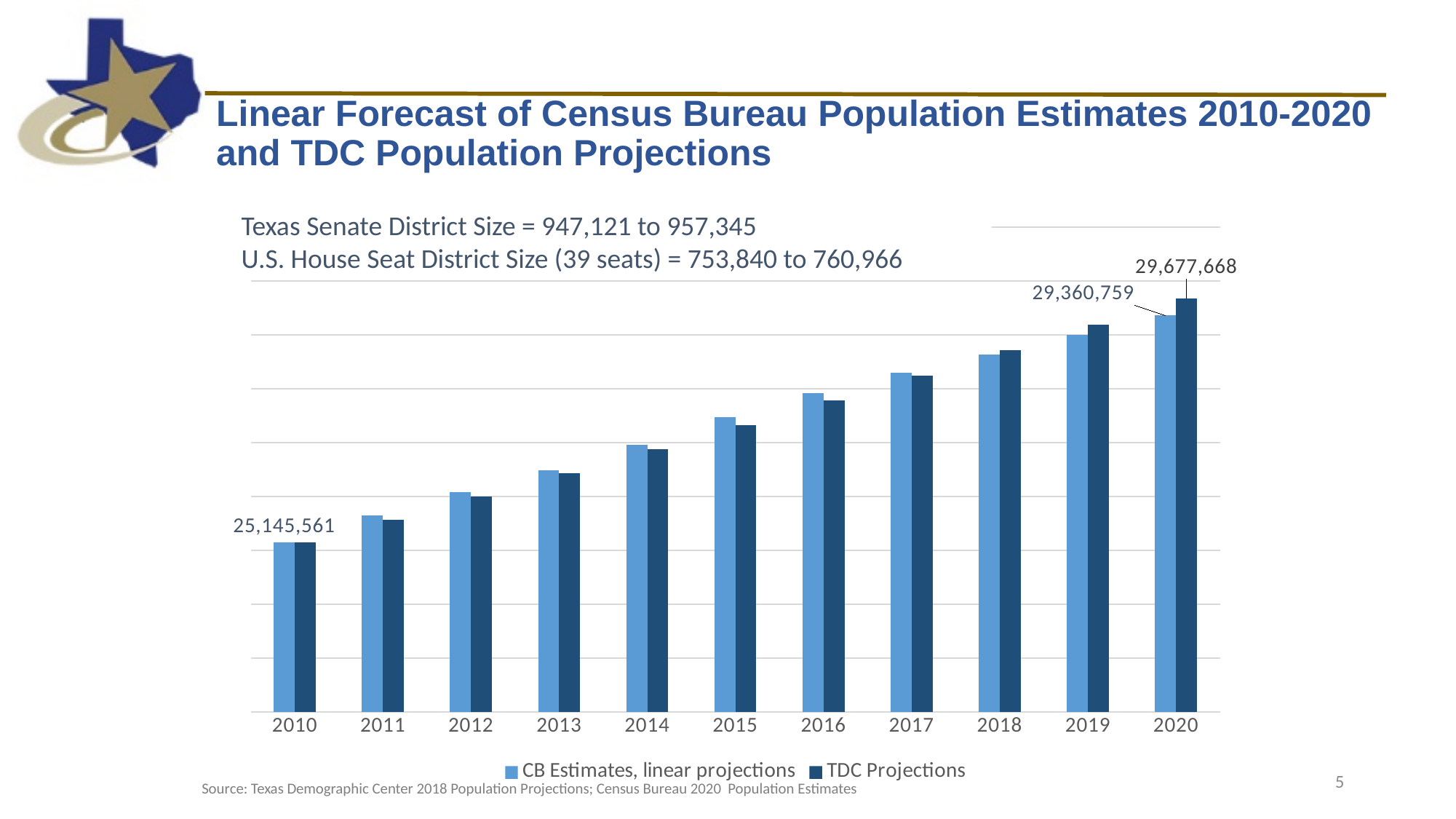
Which year has the highest bar in the chart? 2020 What is the labelled value for the TDC Projections bar in 2020? 29,677,668 How many series does the chart legend list? 2 In 2016, which series has the larger value: CB Estimates, linear projections or TDC Projections? CB Estimates, linear projections What is the labelled population value shown for 2010? 25,145,561 What type of chart is shown on the slide? bar chart What is the difference between the TDC Projections value and the CB Estimates value in 2020? 316,909 In 2020, which series has the larger value: CB Estimates, linear projections or TDC Projections? TDC Projections Do the values rise or fall from 2010 to 2020? rise How many years are shown along the x axis of the chart? 11 What is the labelled value for the CB Estimates, linear projections bar in 2020? 29,360,759 What are the two legend entries of the chart? CB Estimates, linear projections; TDC Projections